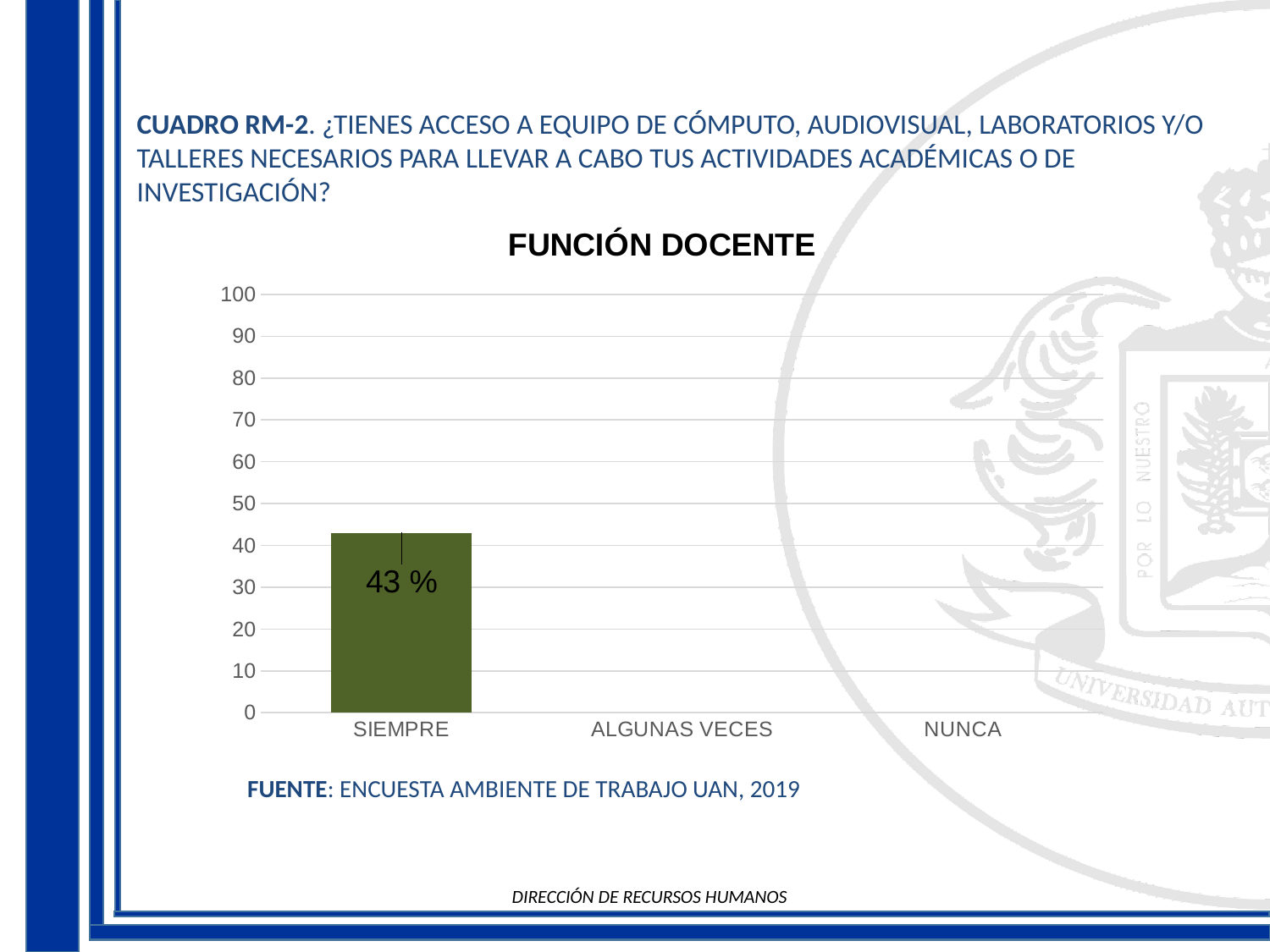
How many categories are listed on the x axis of the chart? 3 Which category is the first one on the x axis of the chart? SIEMPRE What is the highest value shown on the y axis of the chart? 100 What is the value shown for SIEMPRE in the FUNCIÓN DOCENTE chart? 43 % Is the value for SIEMPRE greater or less than 40? greater What is the title of the chart? FUNCIÓN DOCENTE What kind of chart is shown on the slide? bar chart Is the value for SIEMPRE greater or less than 50? less